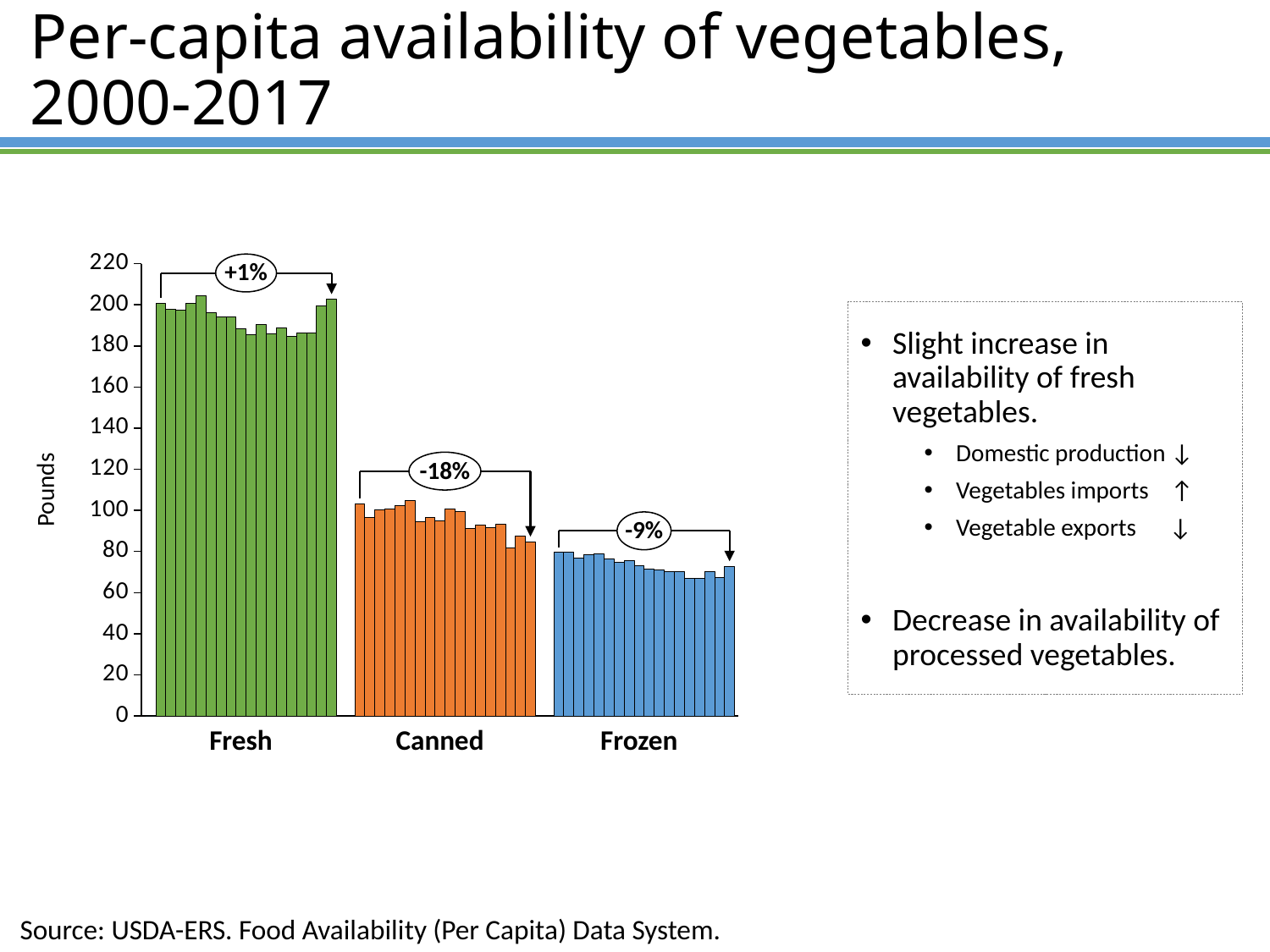
Are the values for Frozen vegetables greater or less than 100 pounds? less Do the Canned vegetable bars rise or fall from 2000 to 2017? fall What percentage change is labelled above the Canned bars? -18% What percentage change is labelled above the Fresh bars? +1% Which has higher per-capita availability, Canned or Frozen vegetables? Canned What is the label on the y axis of the chart? Pounds What percentage change is labelled above the Frozen bars? -9% Which vegetable category has the highest per-capita availability in the chart? Fresh How many vegetable categories are shown on the x axis of the chart? 3 Are the values for Fresh vegetables greater or less than 160 pounds? greater Which vegetable category has the lowest per-capita availability in the chart? Frozen What kind of chart is shown on the slide? bar chart